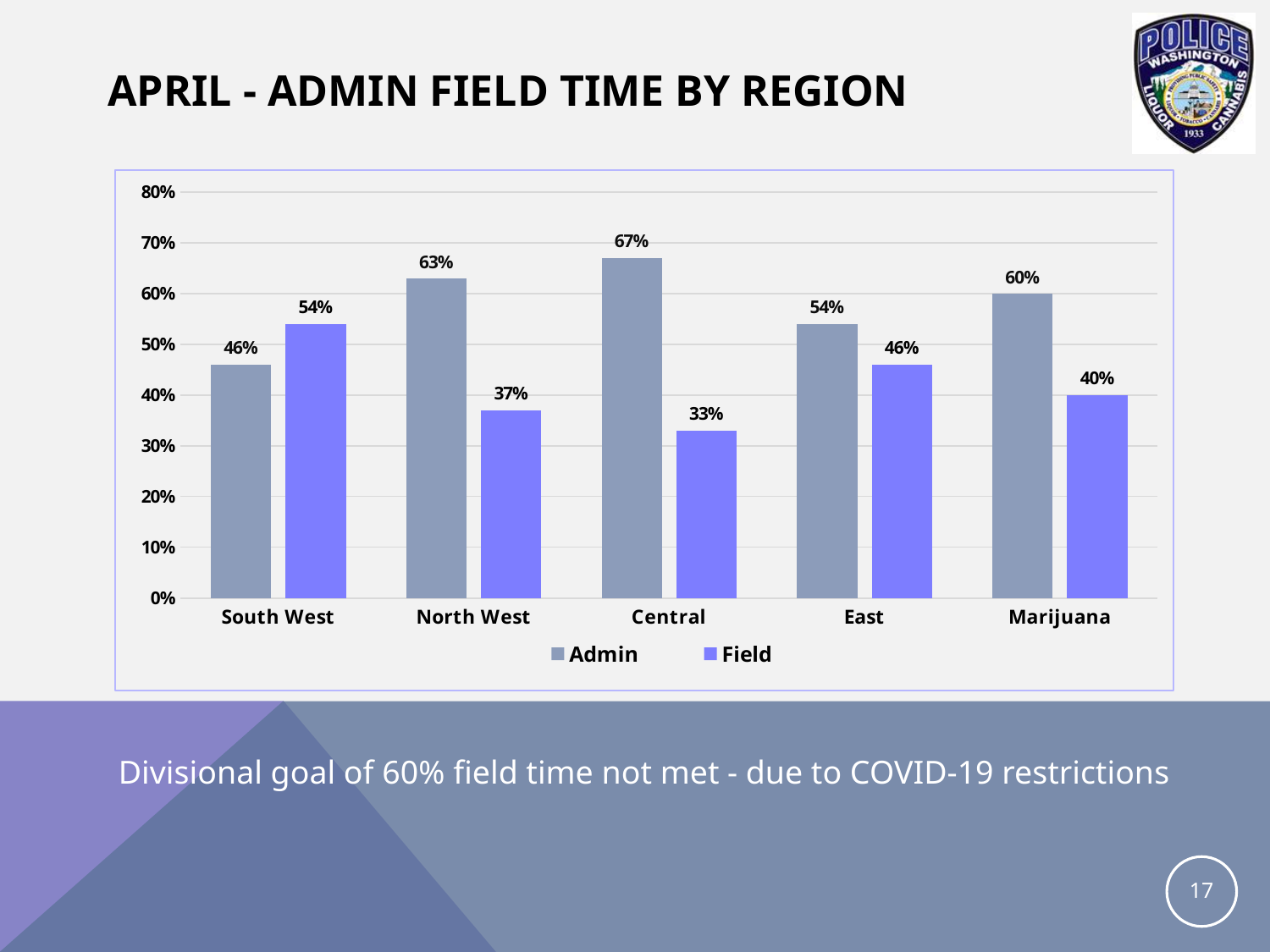
What is the Field value for North West? 37% What kind of chart is shown on the slide? Bar chart How many regions are shown on the x axis? 5 How many series does the legend list? 2 Which is larger for South West, the Admin value or the Field value? Field What is the Field value for Marijuana? 40% Which region has the lowest Field value? Central Which region has the highest Admin value? Central What is the difference between the Admin and Field values for East? 8% Is the Admin value for North West greater or less than 60%? greater What is the Admin value for Central? 67% What are the two series named in the legend? Admin and Field